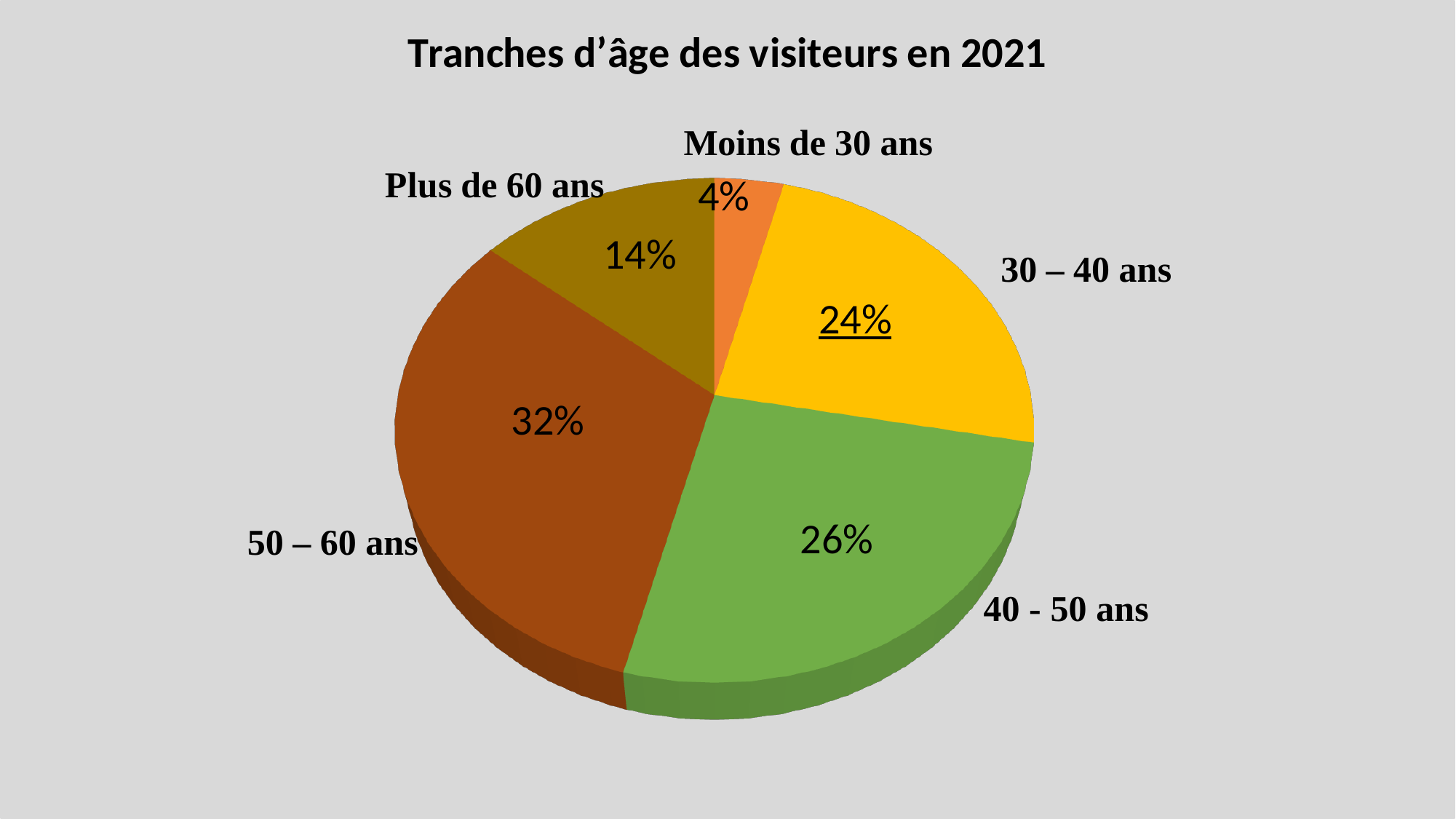
Which age group has the smallest share of visitors? Moins de 30 ans What percentage is shown for 'Plus de 60 ans'? 14% What percentage is shown for the 'Moins de 30 ans' slice? 4% How many age groups are shown in the pie chart? 5 What share does the '30 – 40 ans' slice represent? 24% Which slice is larger: '30 – 40 ans' or '40 - 50 ans'? 40 - 50 ans What type of chart is shown on the slide? Pie chart What is the title of the chart? Tranches d’âge des visiteurs en 2021 What share of visitors in 2021 were aged 50 – 60 ans? 32% What is the difference in percentage points between the '50 – 60 ans' and '40 - 50 ans' slices? 6 Which age group has the largest share of visitors? 50 – 60 ans What colour is the '40 - 50 ans' slice? Green